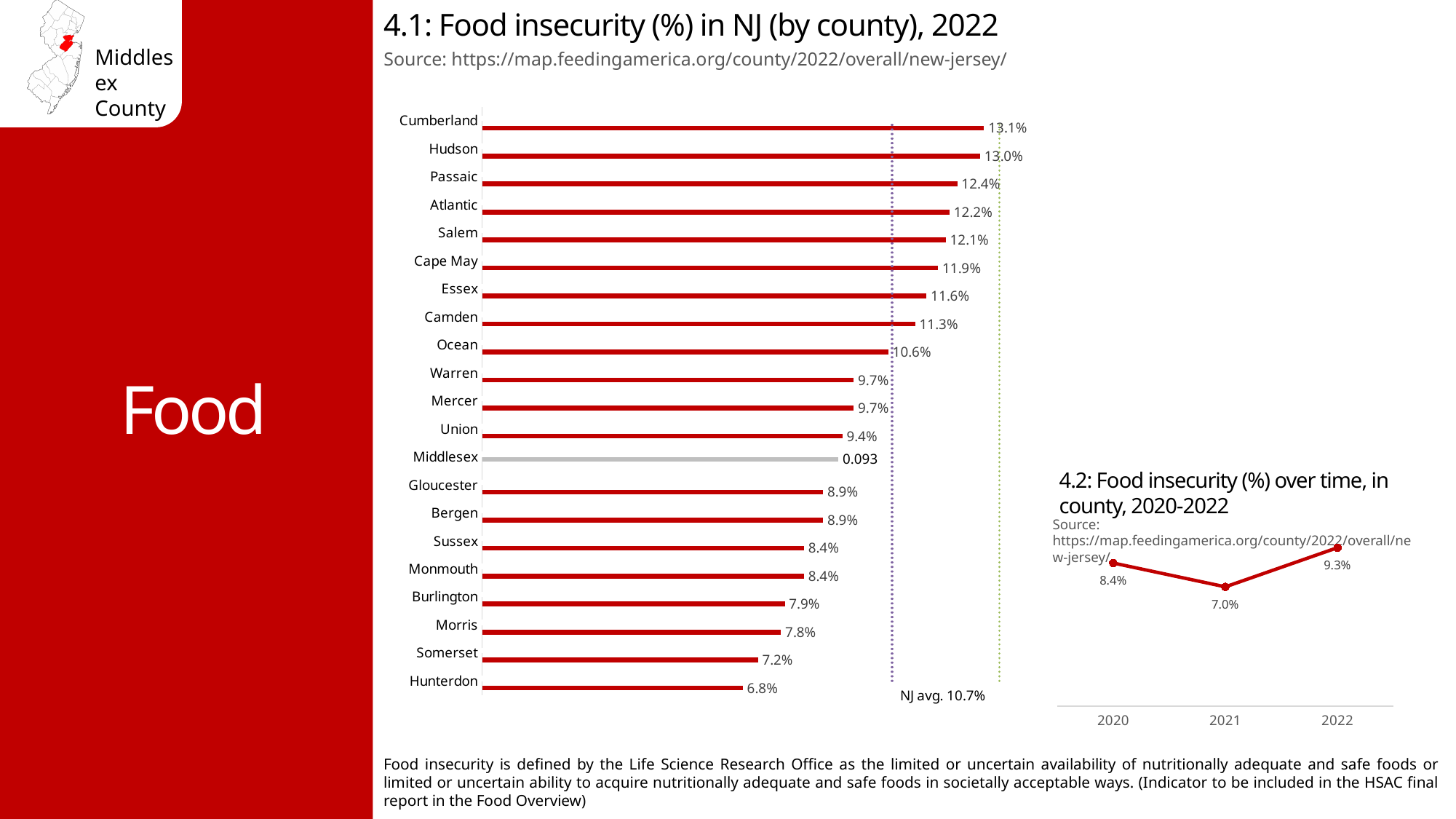
In chart 4.2 (Food insecurity over time, 2020-2022), what is the value for 2021? 7.0% In chart 4.1 (Food insecurity in NJ by county, 2022), what is the difference between Hudson and Somerset? 5.8% In chart 4.1 (Food insecurity in NJ by county, 2022), which county has the lowest food insecurity? Hunterdon In chart 4.1 (Food insecurity in NJ by county, 2022), what is the value shown for Middlesex? 0.093 In chart 4.2 (Food insecurity over time, 2020-2022), what is the difference between 2022 and 2020? 0.9% What kind of chart is chart 4.1 (Food insecurity in NJ by county, 2022)? Bar chart In chart 4.1 (Food insecurity in NJ by county, 2022), what is the value for Cumberland? 13.1% In chart 4.1 (Food insecurity in NJ by county, 2022), which county has the highest food insecurity? Cumberland In chart 4.1 (Food insecurity in NJ by county, 2022), which is larger, Essex or Ocean? Essex In chart 4.1 (Food insecurity in NJ by county, 2022), what NJ average is marked by the dotted line? 10.7% In chart 4.2 (Food insecurity over time, 2020-2022), which year has the highest value? 2022 In chart 4.1 (Food insecurity in NJ by county, 2022), how many counties are plotted? 21